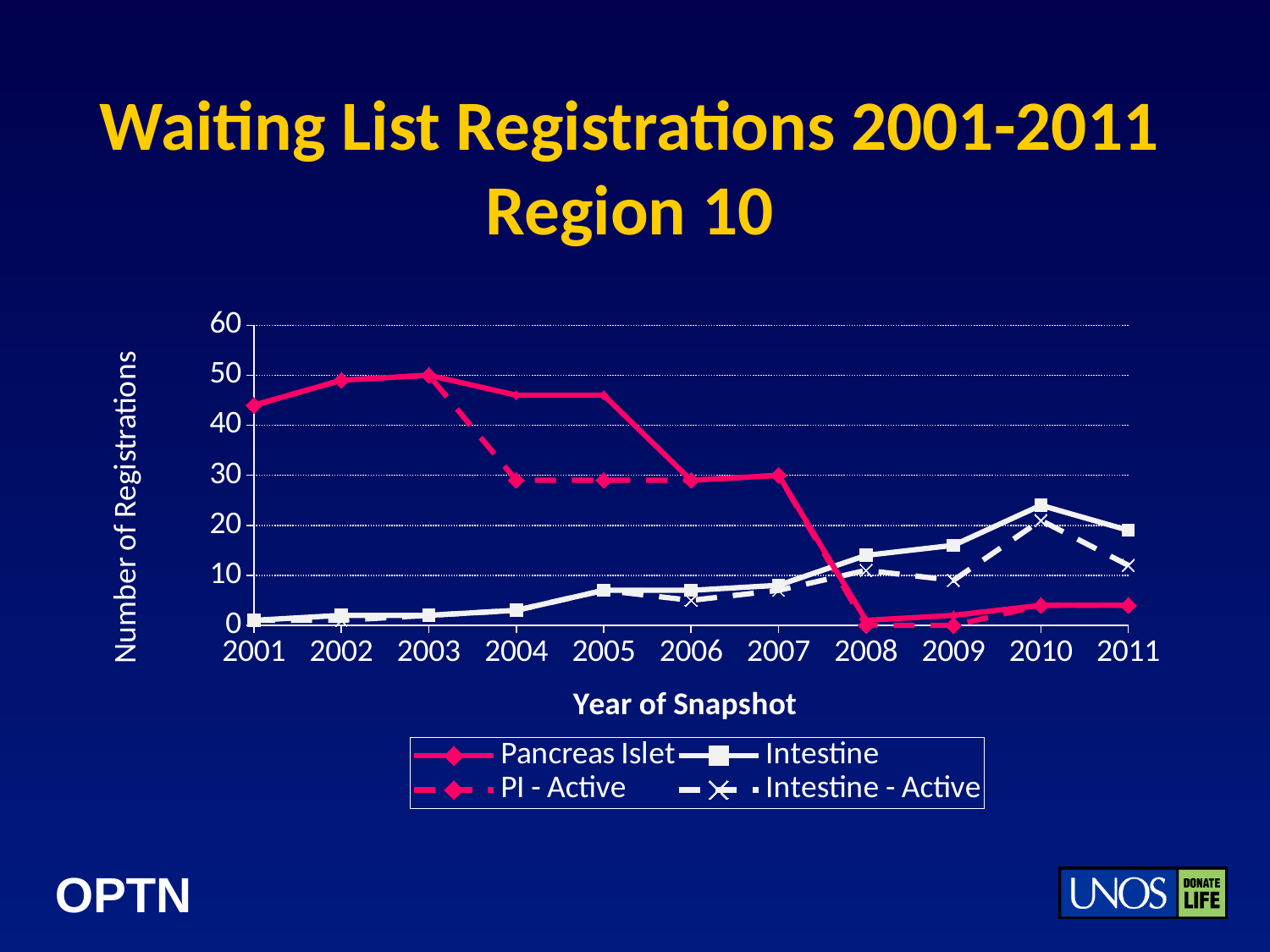
Is the value for PI - Active in 2004 greater or less than 20? greater In which year does the Intestine series reach its highest value? 2010 Is the value for Intestine in 2005 greater or less than 10? less Is the value for Pancreas Islet in 2001 greater or less than 40? greater In 2011, which series has the larger value, Intestine or Intestine - Active? Intestine What kind of chart is shown on the slide? line chart How many years are plotted along the x axis? 11 How many series does the legend list? 4 In 2006, which series has the larger value, Pancreas Islet or Intestine? Pancreas Islet What is the title of the x axis? Year of Snapshot Does the Pancreas Islet series rise or fall from 2003 to 2008? fall